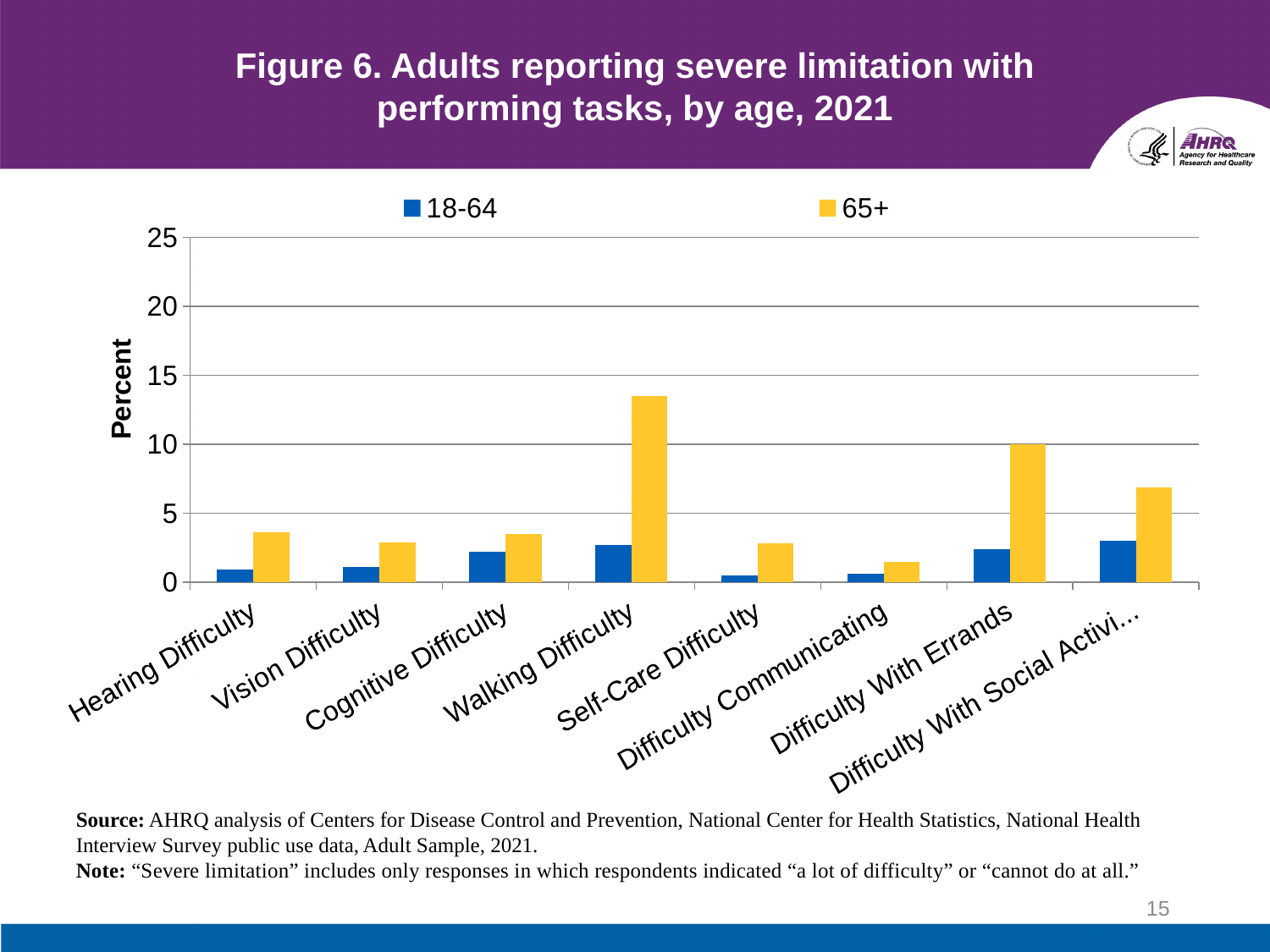
How many task categories are shown along the x axis? 8 For the 65+ series, which is larger: Walking Difficulty or Difficulty With Errands? Walking Difficulty Is the 18-64 value for Walking Difficulty greater or less than 5? less What is the label on the vertical axis? Percent Is the 65+ value for Hearing Difficulty greater or less than 5? less Which colour represents the 65+ series in the legend? yellow For the 65+ series, which category has the lowest value? Difficulty Communicating For Hearing Difficulty, which age group has the larger value: 18-64 or 65+? 65+ What kind of chart is shown on the slide? bar chart Is the 65+ value for Walking Difficulty greater or less than 10? greater For the 65+ series, which category has the highest value? Walking Difficulty How many series does the legend list? 2